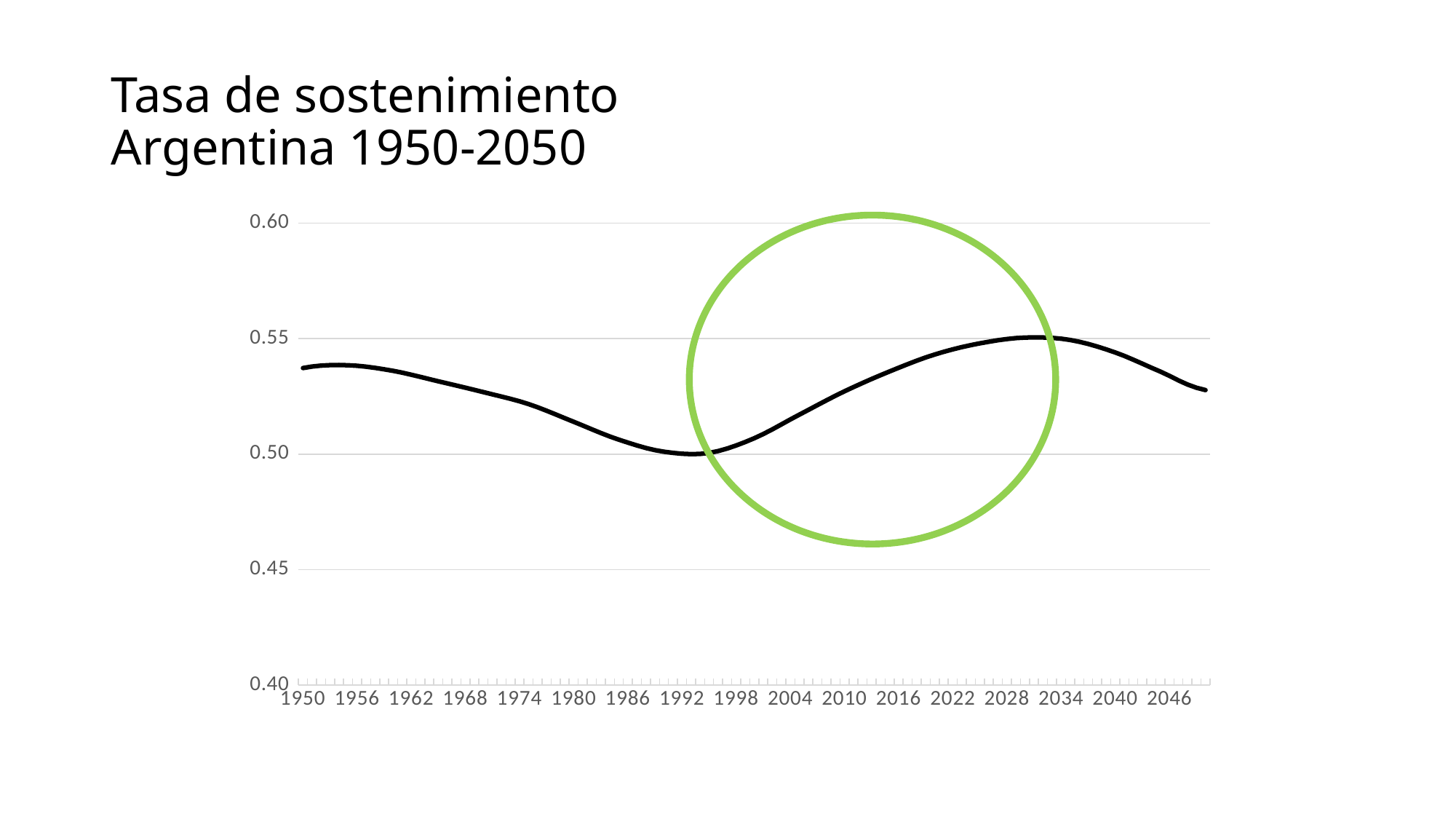
Is the value for 2046 greater or less than 0.55? less What is the title of the chart on the slide? Tasa de sostenimiento Argentina 1950-2050 Does the value rise or fall along the x axis between 2034 and 2046? fall What colour is the circle drawn over the chart? green Is the value for 1950 greater or less than 0.50? greater Does the value rise or fall along the x axis between 1998 and 2028? rise Is the value for 1974 greater or less than 0.50? greater Which is larger, the value for 1950 or the value for 1992? 1950 Does the value rise or fall along the x axis between 1950 and 1992? fall How many lines (series) are plotted on the chart? 1 What kind of chart is shown on the slide? line chart